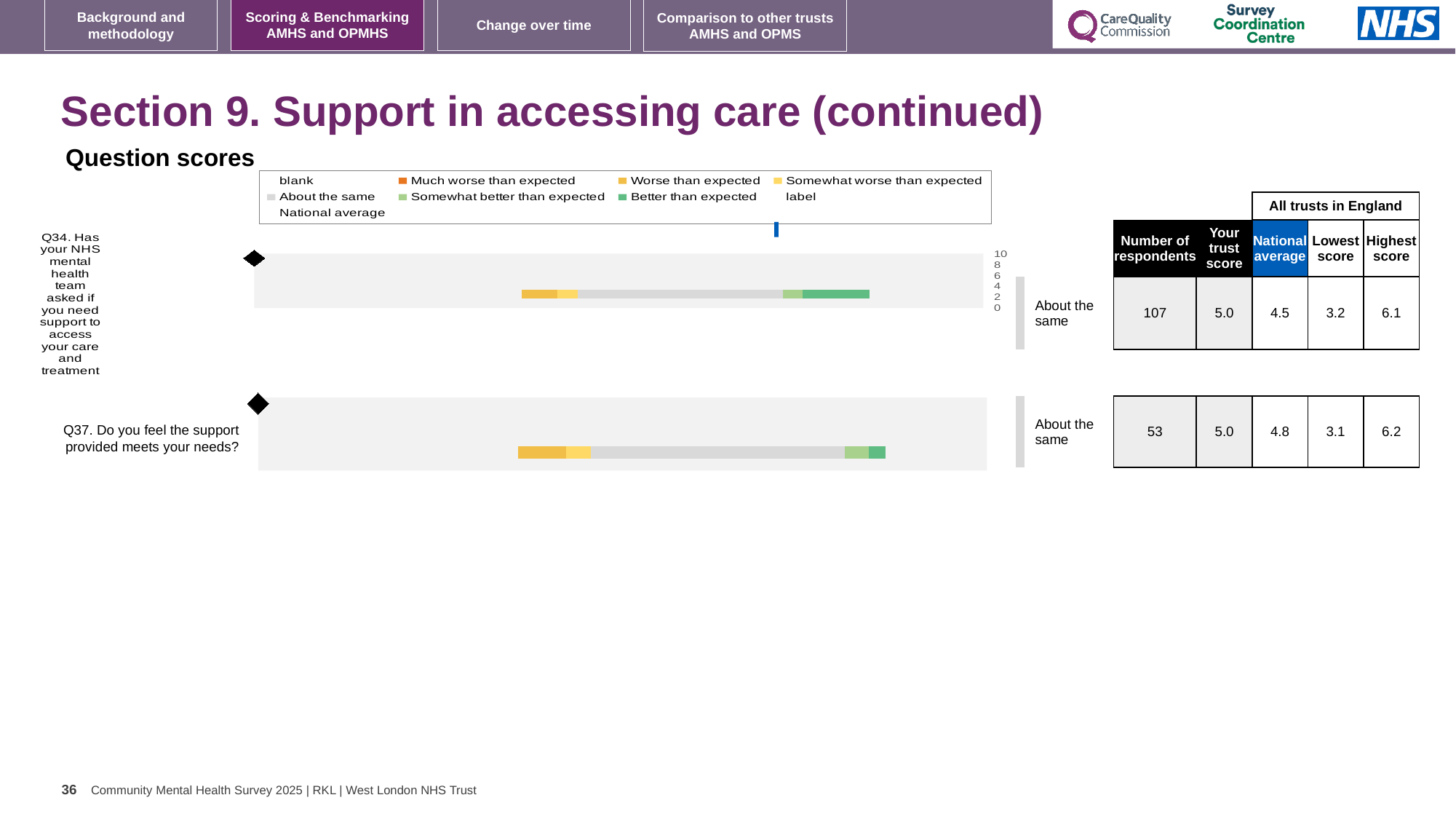
What is the national average for Q34? 4.5 How many questions are plotted in the question scores chart? 2 What colour does the legend use for 'Better than expected'? green What is the highest score across all trusts in England for Q37? 6.2 What kind of chart is used to show the question scores on this slide? bar chart How much higher is the national average for Q37 than for Q34? 0.3 What is the difference between the highest score and the lowest score for Q34? 2.9 How many respondents are shown for Q34 (Has your NHS mental health team asked if you need support to access your care and treatment)? 107 For Q34, is the trust score higher or lower than the national average? higher Which benchmark category is Q37 placed in? About the same Which question has more respondents, Q34 or Q37? Q34 What is the trust score for Q37 (Do you feel the support provided meets your needs)? 5.0